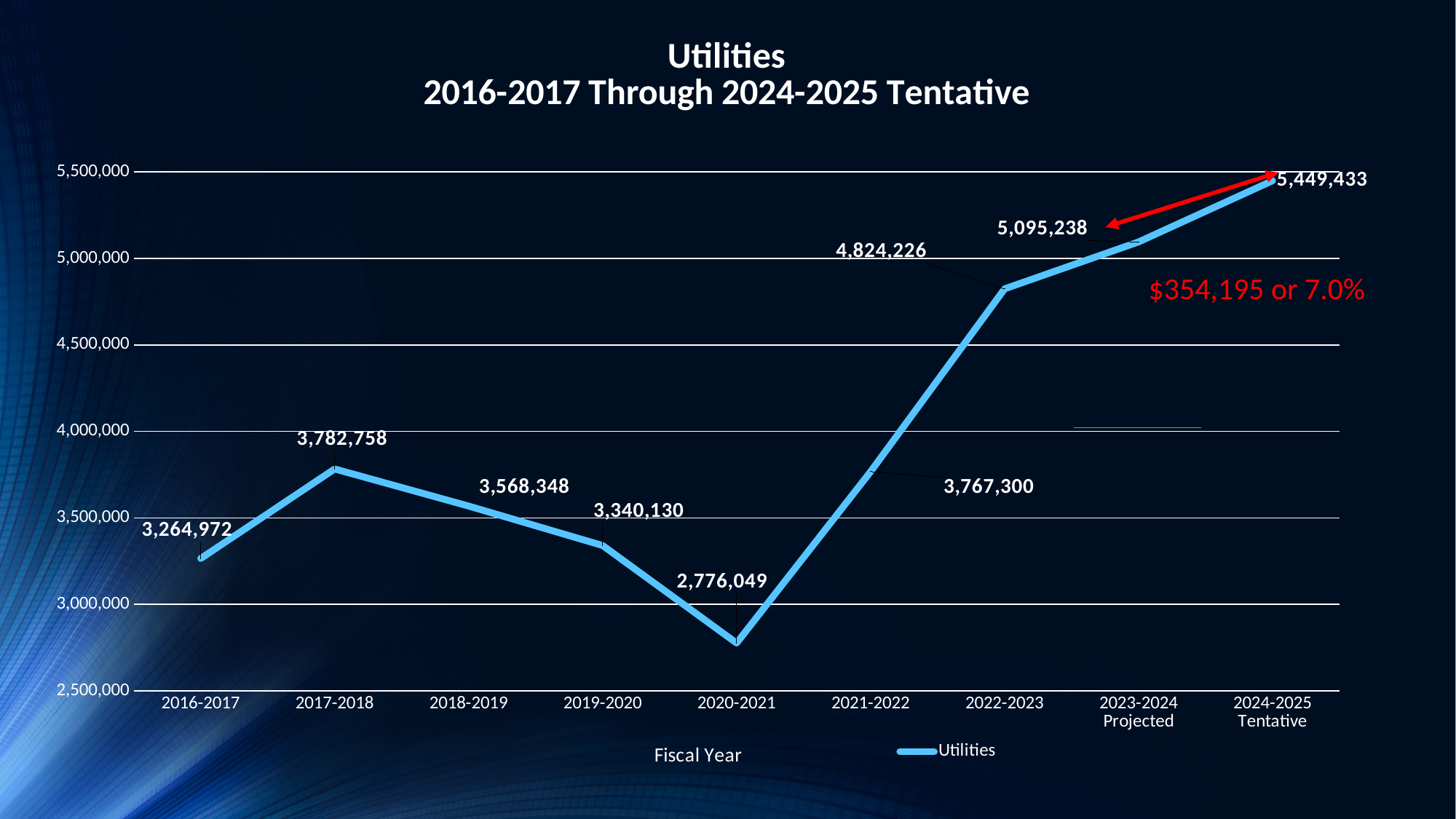
Which fiscal year has the lowest Utilities value? 2020-2021 Which is larger, the Utilities value for 2018-2019 or for 2021-2022? 2021-2022 Which fiscal year has the highest Utilities value? 2024-2025 Tentative What kind of chart is shown on the slide? Line chart What is the difference between the Utilities values for 2024-2025 Tentative and 2023-2024 Projected? 354,195 What is the Utilities value for 2020-2021? 2,776,049 What is the Utilities value for 2016-2017? 3,264,972 Does the Utilities value rise or fall from 2017-2018 to 2020-2021? Fall What is the Utilities value for 2022-2023? 4,824,226 What is the difference between the Utilities values for 2017-2018 and 2016-2017? 517,786 What is the Utilities value for 2024-2025 Tentative? 5,449,433 How many fiscal years are plotted on the chart? 9